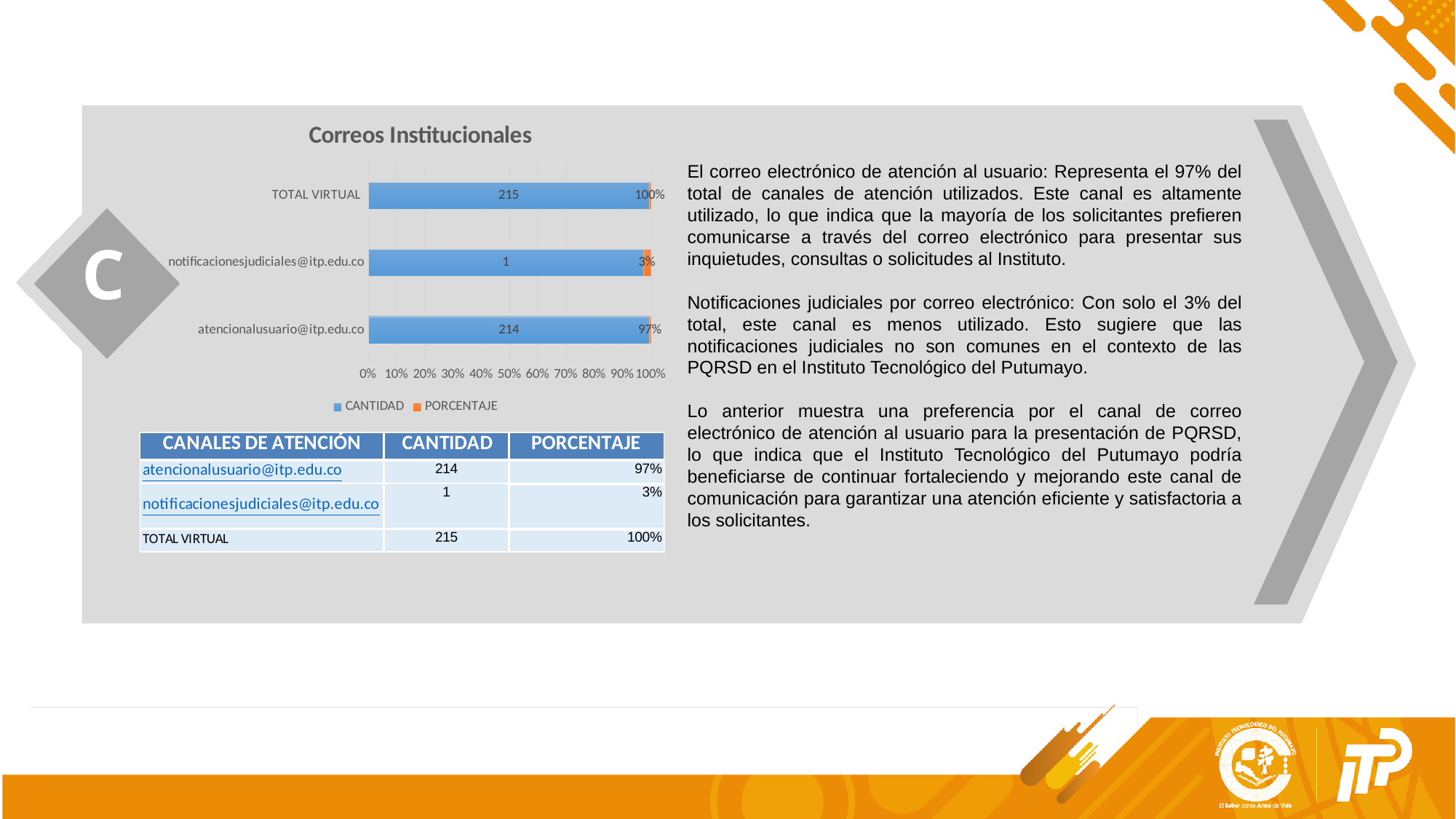
What is the CANTIDAD value for TOTAL VIRTUAL in the chart? 215 What is the CANTIDAD value for atencionalusuario@itp.edu.co in the chart? 214 Which legend entry is shown in orange in the 'Correos Institucionales' chart? PORCENTAJE What is the PORCENTAJE value for notificacionesjudiciales@itp.edu.co in the chart? 3% How many categories are plotted in the 'Correos Institucionales' chart? 3 What type of chart is shown under the title 'Correos Institucionales'? bar chart Which category has the lowest CANTIDAD value in the chart? notificacionesjudiciales@itp.edu.co How many series does the legend of the 'Correos Institucionales' chart list? 2 What is the title of the chart on the slide? Correos Institucionales What is the difference in CANTIDAD between atencionalusuario@itp.edu.co and notificacionesjudiciales@itp.edu.co? 213 What is the PORCENTAJE value for atencionalusuario@itp.edu.co in the chart? 97% Which has a larger PORCENTAJE value, atencionalusuario@itp.edu.co or notificacionesjudiciales@itp.edu.co? atencionalusuario@itp.edu.co